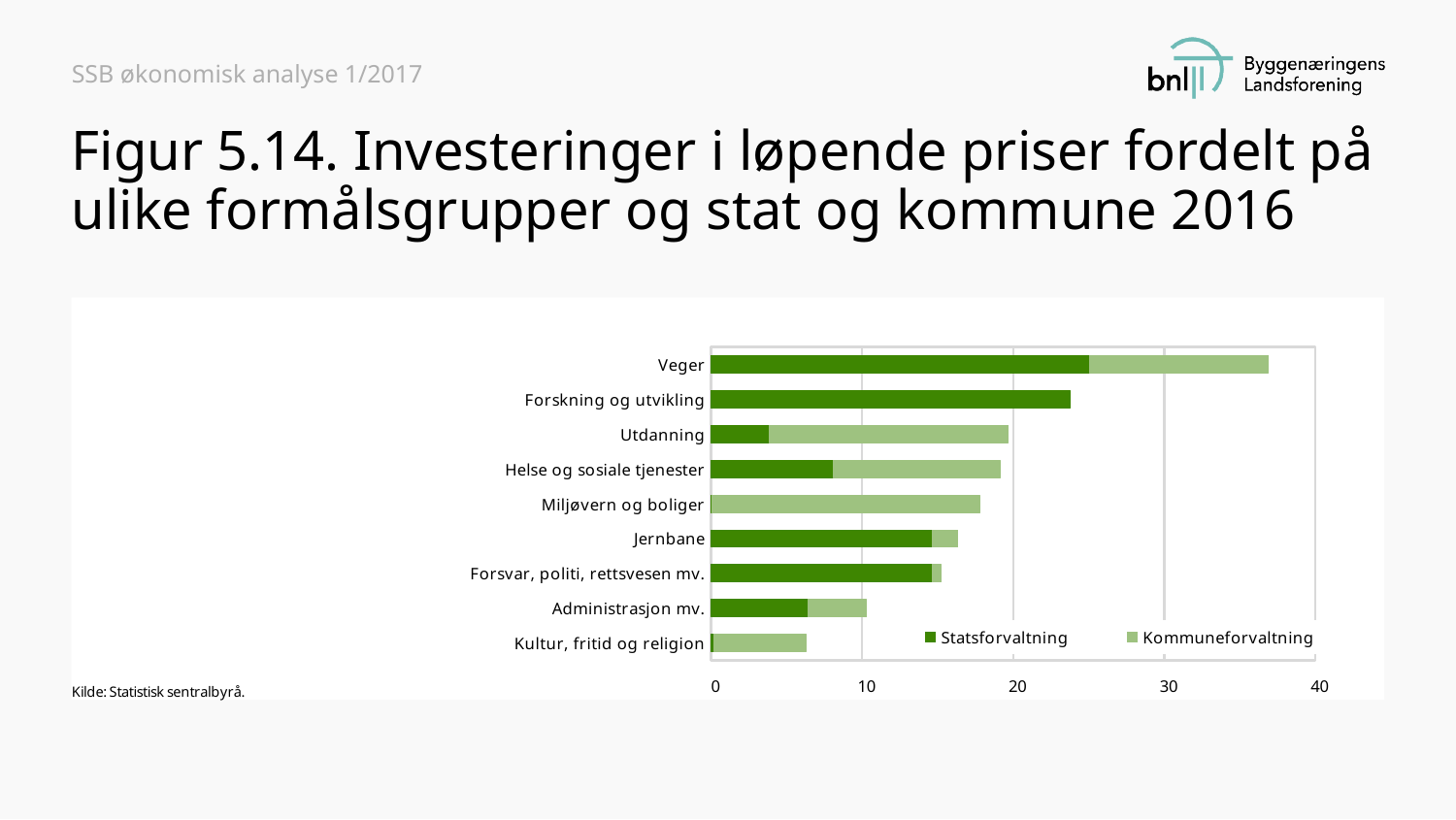
Is the total value for Forskning og utvikling greater or less than 20? greater Is the total value for Jernbane greater or less than 10? greater Is the total value for Veger greater or less than 30? greater Which two series are listed in the legend? Statsforvaltning and Kommuneforvaltning How many series does the legend list? 2 What kind of chart is shown on the slide? Stacked horizontal bar chart Which has the larger Statsforvaltning value, Utdanning or Helse og sosiale tjenester? Helse og sosiale tjenester How many categories (formålsgrupper) are shown on the chart? 9 Which category has the lowest total investment? Kultur, fritid og religion Which has the larger total investment, Veger or Forskning og utvikling? Veger Which category has the highest total investment? Veger